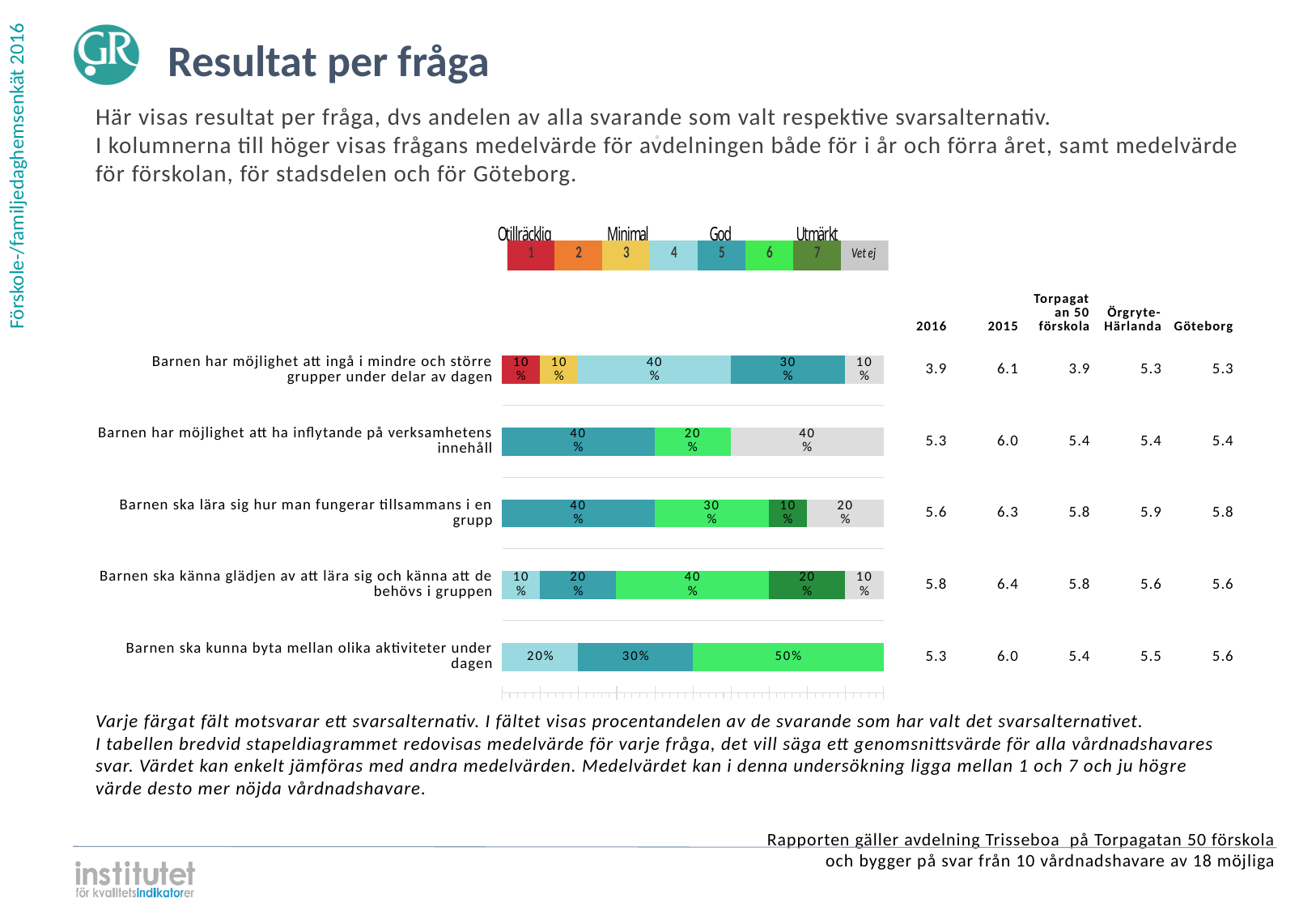
How many answer alternatives does the colour legend above the chart list? 8 What is the title of the slide containing the chart? Resultat per fråga What is the difference between the share for alternative 5 and the share for alternative 7 in 'Barnen ska lära sig hur man fungerar tillsammans i en grupp'? 30 percentage points What percentage of respondents chose alternative 6 (bright green) for 'Barnen ska kunna byta mellan olika aktiviteter under dagen'? 50% How many questions (categories) are plotted as bars in the chart? 5 For 'Barnen ska kunna byta mellan olika aktiviteter under dagen', which is larger: the share for alternative 4 (light blue) or alternative 5 (teal)? Alternative 5 (30%) What percentage of respondents chose alternative 1 (red) for 'Barnen har möjlighet att ingå i mindre och större grupper under delar av dagen'? 10% What percentage of respondents answered 'Vet ej' (grey) for 'Barnen har möjlighet att ha inflytande på verksamhetens innehåll'? 40% What kind of chart is shown on the slide? Stacked bar chart What is the total of all segments in the bar for 'Barnen ska kunna byta mellan olika aktiviteter under dagen'? 100% What is the 2016 mean value shown for 'Barnen har möjlighet att ingå i mindre och större grupper under delar av dagen'? 3.9 Which answer alternative has the largest share for 'Barnen ska känna glädjen av att lära sig och känna att de behövs i gruppen'? 6 (40%)